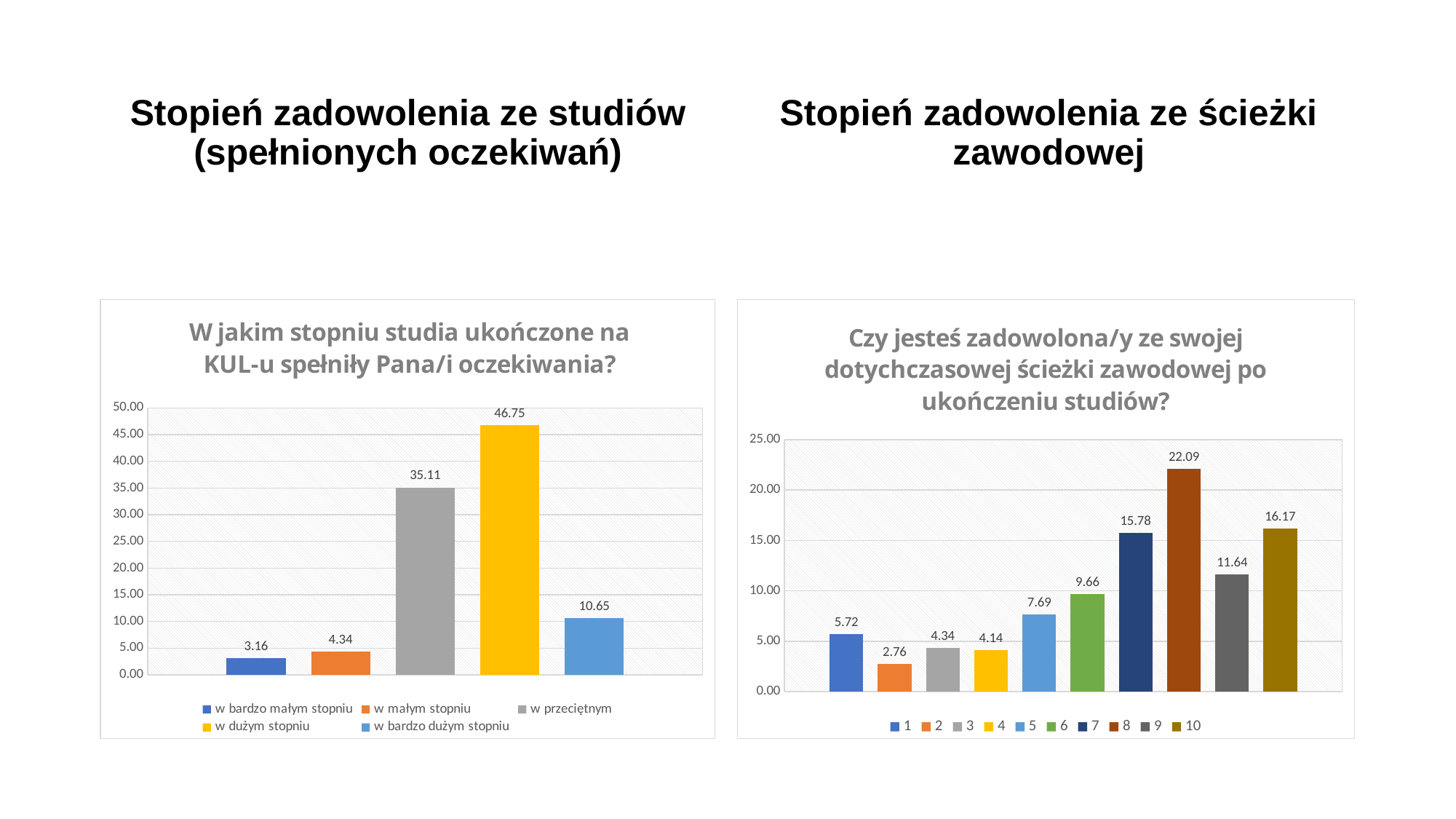
In the left chart, what is the value for "w bardzo małym stopniu"? 3.16 In the left chart, what is the value for "w dużym stopniu"? 46.75 In the left chart, how many categories are shown in the legend? 5 In the right chart, which category has the lowest value? 2 In the left chart, which category has the highest value? w dużym stopniu In the right chart, how many bars are plotted? 10 In the right chart, what is the value for category 8? 22.09 What type of chart is the right chart? bar chart In the right chart, which is larger, the value for category 7 or category 10? category 10 In the left chart, what is the difference between the values for "w dużym stopniu" and "w przeciętnym"? 11.64 In the left chart, which category has the lowest value? w bardzo małym stopniu In the right chart, what is the value for category 2? 2.76